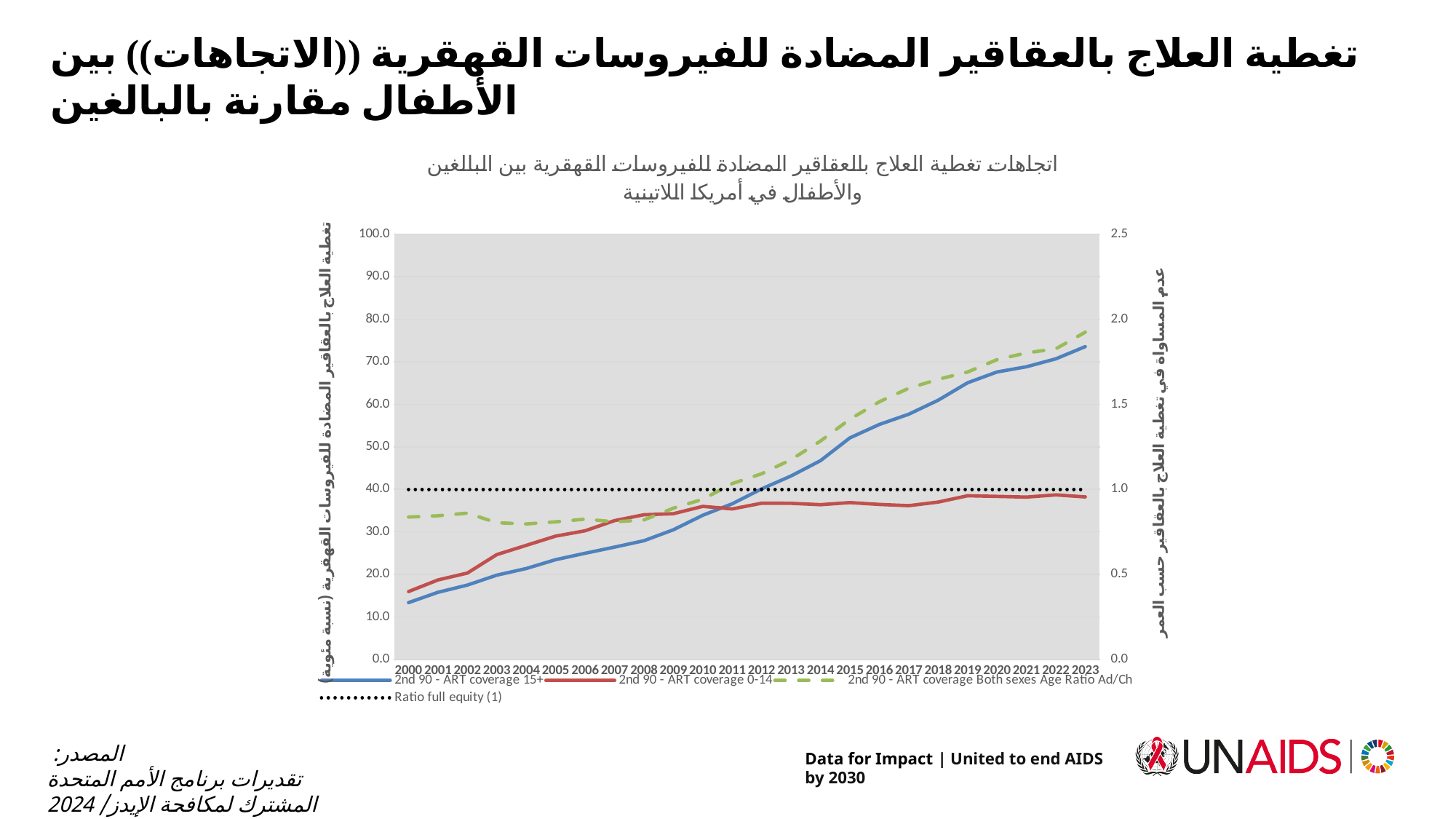
How many years are plotted along the x axis of the chart? 24 How many series does the chart legend list? 4 Does the '2nd 90 - ART coverage 15+' series rise or fall from 2000 to 2023? rise What kind of chart is shown on the slide? line chart In 2005, which is larger: '2nd 90 - ART coverage 15+' or '2nd 90 - ART coverage 0-14'? 2nd 90 - ART coverage 0-14 Which series is drawn as a green dashed line? 2nd 90 - ART coverage Both sexes Age Ratio Ad/Ch Which series is drawn as a black dotted line? Ratio full equity (1) Is the value for '2nd 90 - ART coverage 0-14' in 2023 greater or less than 40.0 on the left axis? less Is the value for '2nd 90 - ART coverage 15+' in 2000 greater or less than 20.0 on the left axis? less In 2023, which is larger: '2nd 90 - ART coverage 15+' or '2nd 90 - ART coverage 0-14'? 2nd 90 - ART coverage 15+ Is the value for '2nd 90 - ART coverage Both sexes Age Ratio Ad/Ch' in 2023 greater or less than 1.5 on the right axis? greater